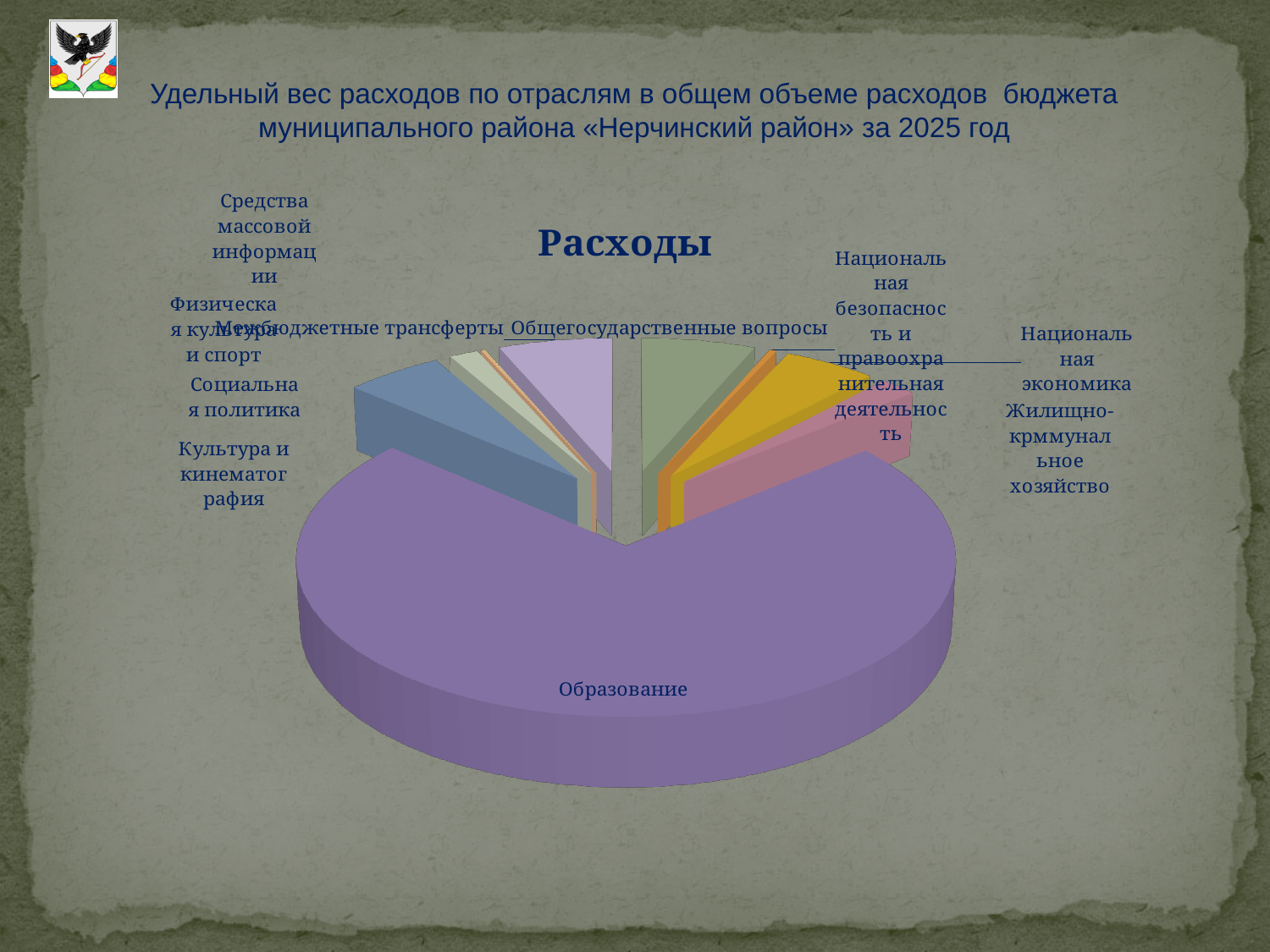
Which category has the largest share of the pie? Образование Does the slice for Образование take up more or less than half of the pie? more Which is larger, the slice for Образование or the slice for Социальная политика? Образование How many categories are labelled on the pie chart? 10 What colour is the slice for Образование? purple Which is larger, the slice for Образование or the slice for Общегосударственные вопросы? Образование What kind of chart is shown on the slide? pie chart What is the title of the chart? Расходы